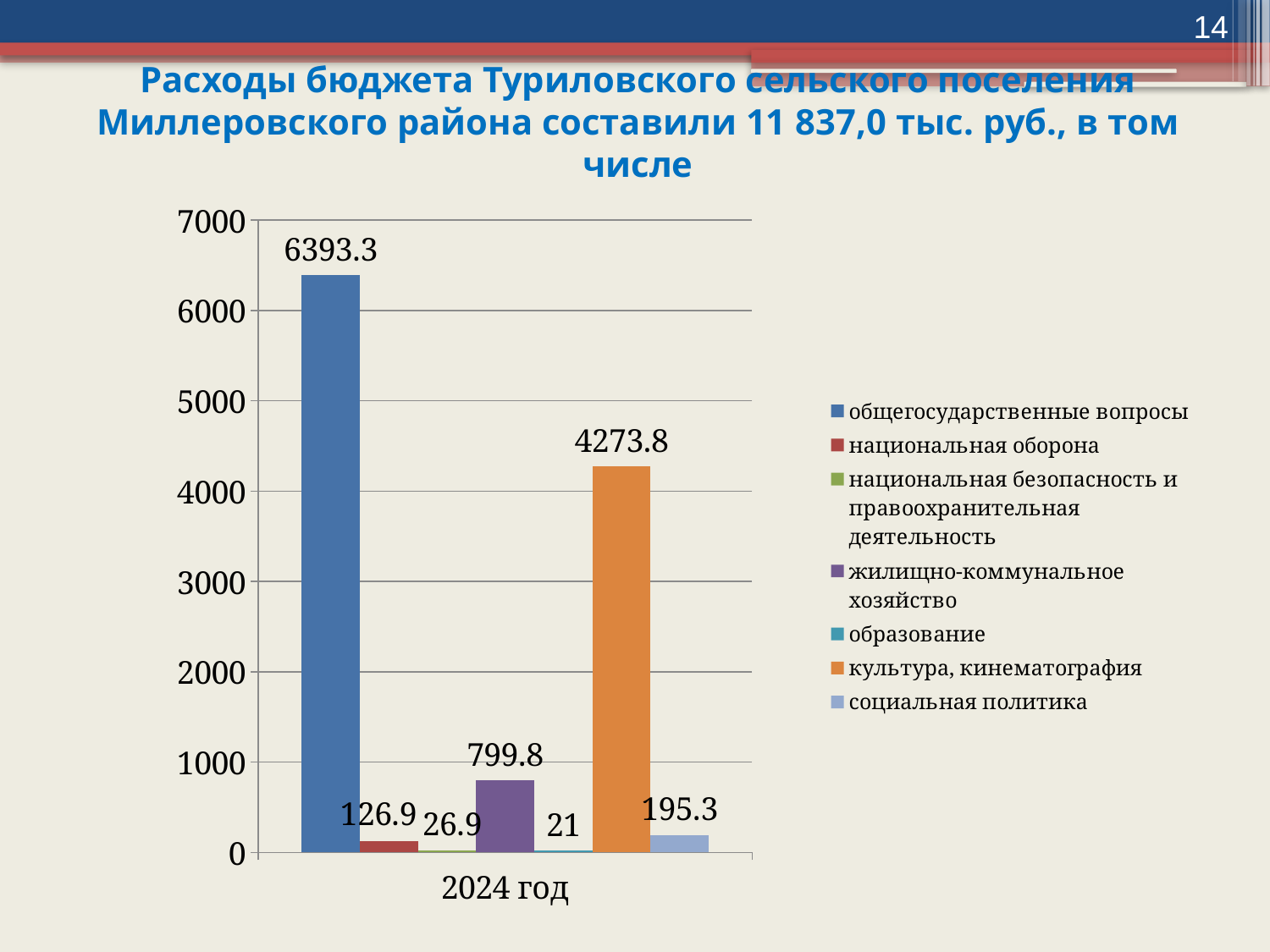
Is the value for жилищно-коммунальное хозяйство greater or less than 1000? less Which is larger in 2024 год: национальная оборона or социальная политика? социальная политика What is the value for образование in 2024 год? 21 What is the value for жилищно-коммунальное хозяйство in 2024 год? 799.8 What kind of chart is shown on the slide? bar chart What is the value for культура, кинематография in 2024 год? 4273.8 Which series has the highest value in 2024 год? общегосударственные вопросы What is the value for общегосударственные вопросы in 2024 год? 6393.3 How many series does the legend list? 7 Which series has the lowest value in 2024 год? образование What is the difference between общегосударственные вопросы and культура, кинематография in 2024 год? 2119.5 What colour is the bar for культура, кинематография? orange